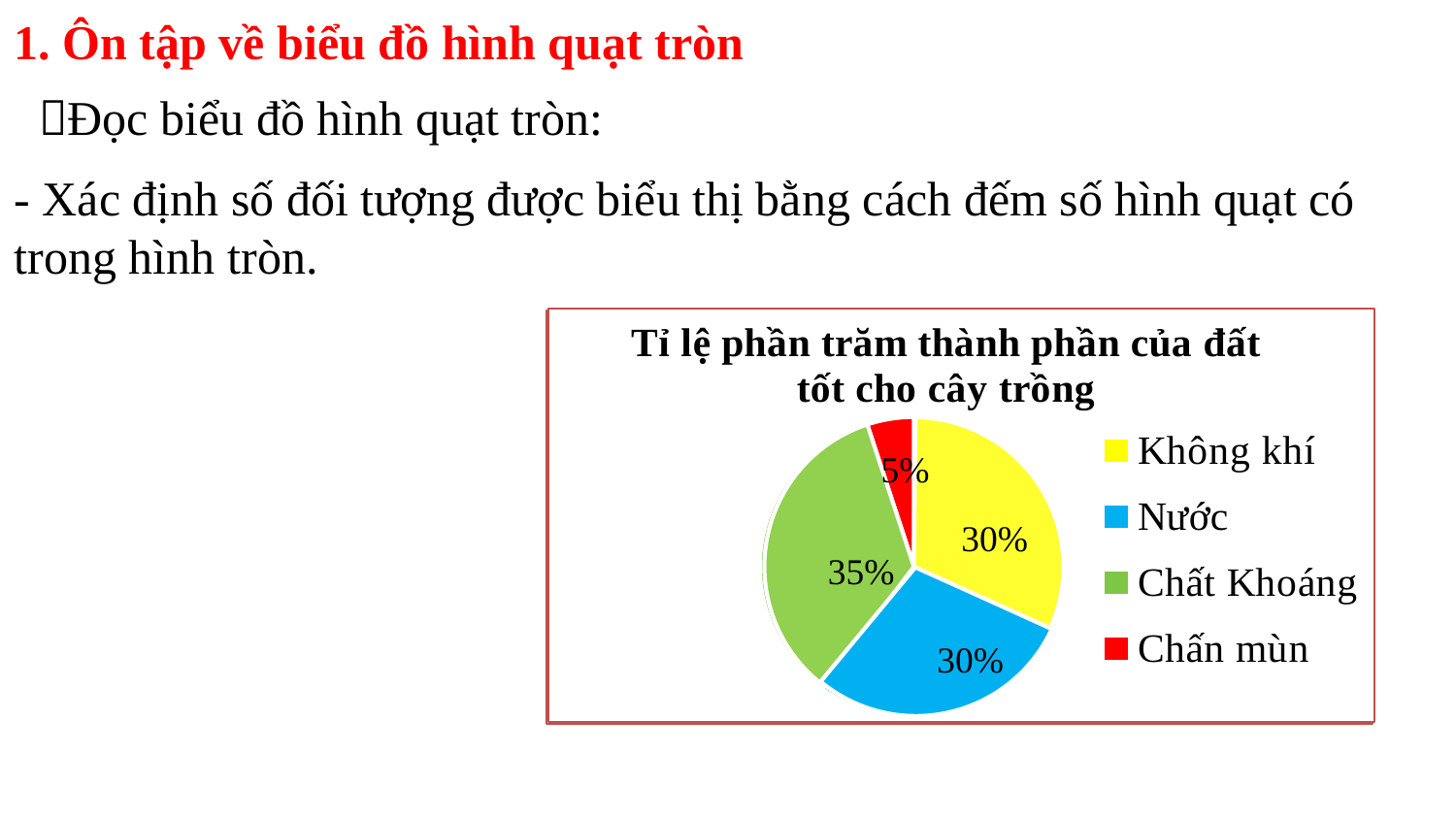
Which colour represents Nước in the pie chart? Blue What is the difference between the shares of Chất Khoáng and Chấn mùn? 30% Which is larger, the share of Chất Khoáng or the share of Nước? Chất Khoáng What percentage does the Không khí slice represent? 30% How many categories does the pie chart show? 4 Which category has the largest share of the pie? Chất Khoáng What percentage does the Nước slice represent? 30% What percentage does the Chất Khoáng slice represent? 35% What is the title of the pie chart? Tỉ lệ phần trăm thành phần của đất tốt cho cây trồng What kind of chart is shown on the slide? Pie chart Which category has the smallest share of the pie? Chấn mùn What percentage does the Chấn mùn slice represent? 5%